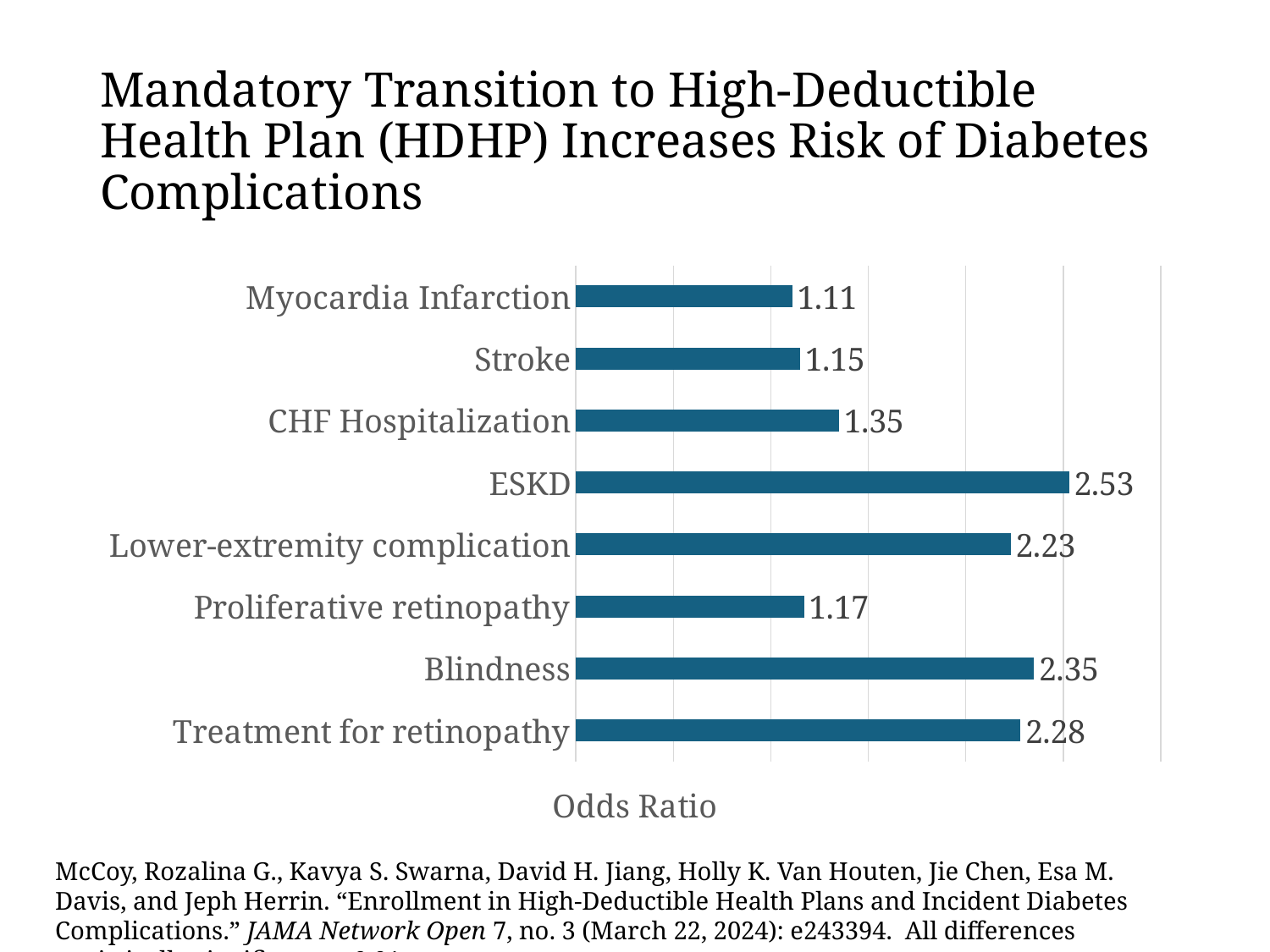
How many complications are shown in the chart? 8 What is the odds ratio for Blindness? 2.35 What is the odds ratio for CHF Hospitalization? 1.35 What is the odds ratio for Stroke? 1.15 What is the odds ratio for ESKD? 2.53 What is the title of the horizontal axis? Odds Ratio Which complication has the highest odds ratio? ESKD What is the difference between the odds ratios for ESKD and Myocardia Infarction? 1.42 What is the difference between the odds ratios for Lower-extremity complication and CHF Hospitalization? 0.88 Which complication has the lowest odds ratio? Myocardia Infarction What type of chart is shown on the slide? Bar chart Which has a larger odds ratio, Blindness or Treatment for retinopathy? Blindness